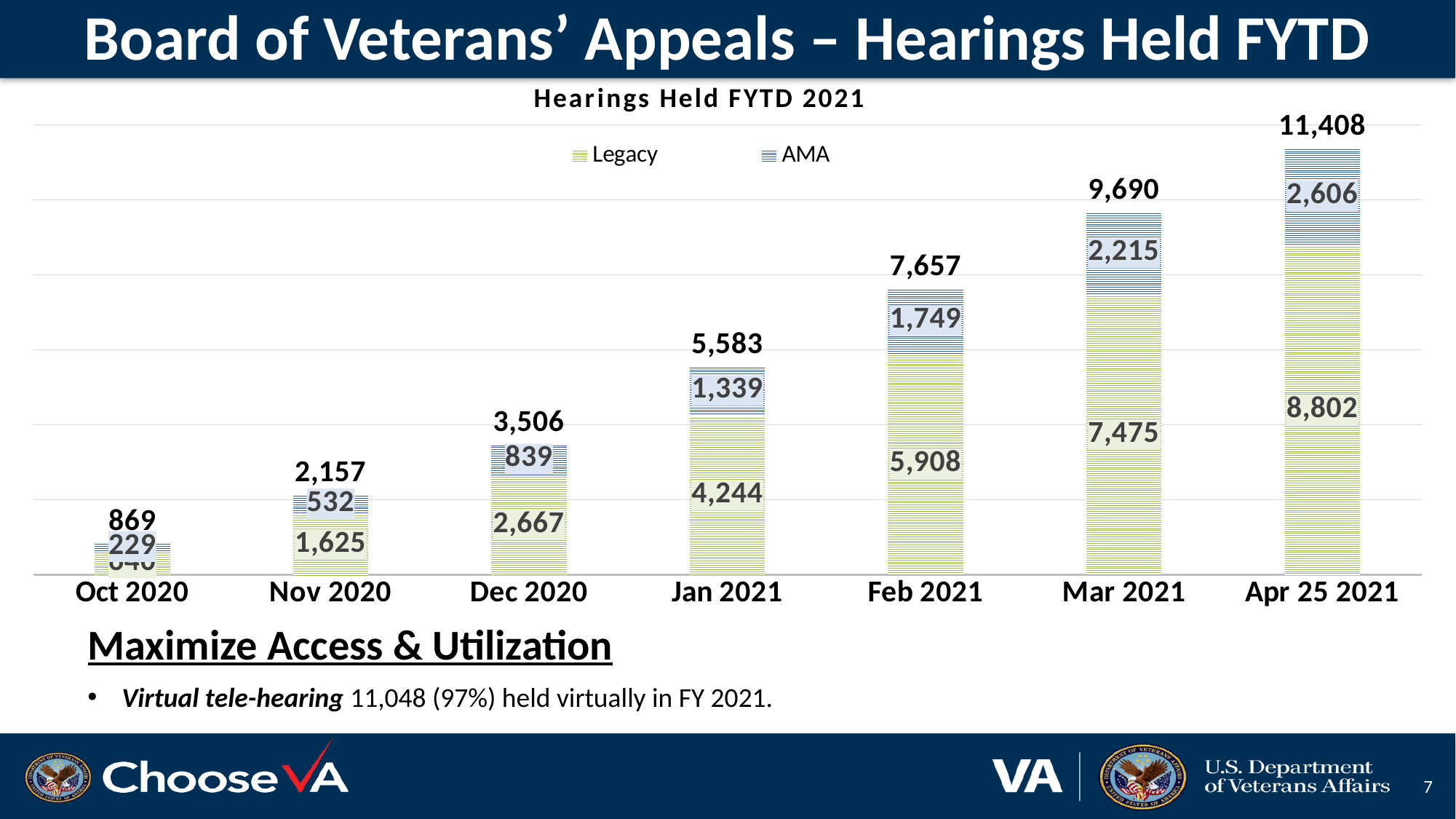
How many series does the legend list? 2 Do the total hearings held FYTD rise or fall from Oct 2020 to Apr 25 2021? Rise What type of chart is shown on the slide? Stacked bar chart Which month has the highest total hearings held FYTD? Apr 25 2021 What is the Legacy value for Mar 2021? 7,475 What is the title of the chart? Hearings Held FYTD 2021 What is the AMA value for Feb 2021? 1,749 Which month has the lowest total hearings held FYTD? Oct 2020 How many months (categories) are shown on the x axis? 7 Which is larger, the AMA value for Nov 2020 or the AMA value for Dec 2020? Dec 2020 What is the difference between the Legacy values for Jan 2021 and Dec 2020? 1,577 What is the total number of hearings held FYTD shown for Apr 25 2021? 11,408